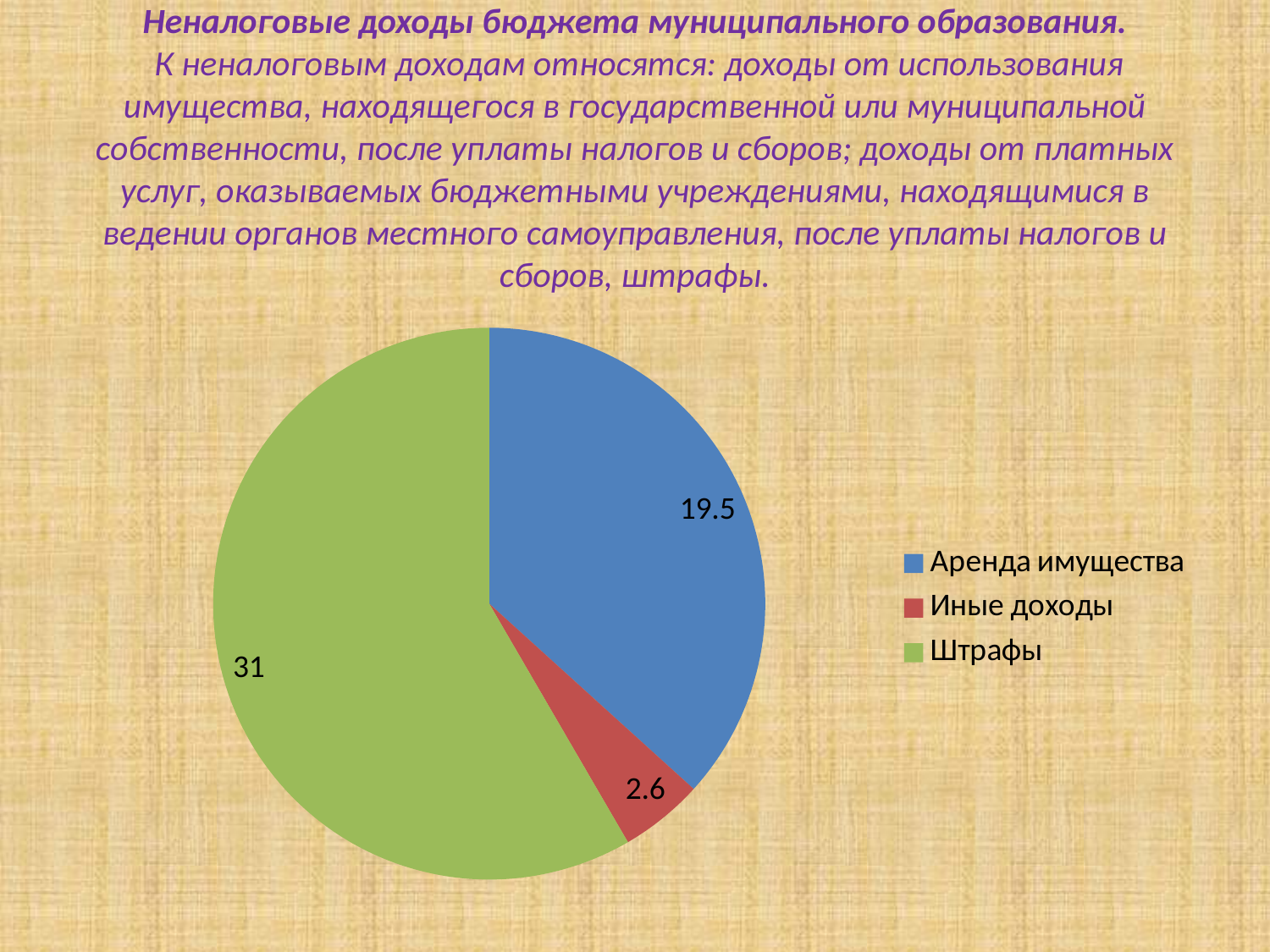
Which is larger, the value for Аренда имущества or the value for Иные доходы? Аренда имущества How many slices does the pie chart have? 3 What is the value for Штрафы? 31 Which category has the largest slice of the pie? Штрафы What is the value for Иные доходы? 2.6 Which category has the smallest slice of the pie? Иные доходы What type of chart is shown on the slide? pie chart What is the difference between the values for Аренда имущества and Иные доходы? 16.9 Which colour represents Штрафы in the pie chart? green What is the difference between the values for Штрафы and Аренда имущества? 11.5 What is the total of all three slices in the pie chart? 53.1 What is the value for Аренда имущества? 19.5